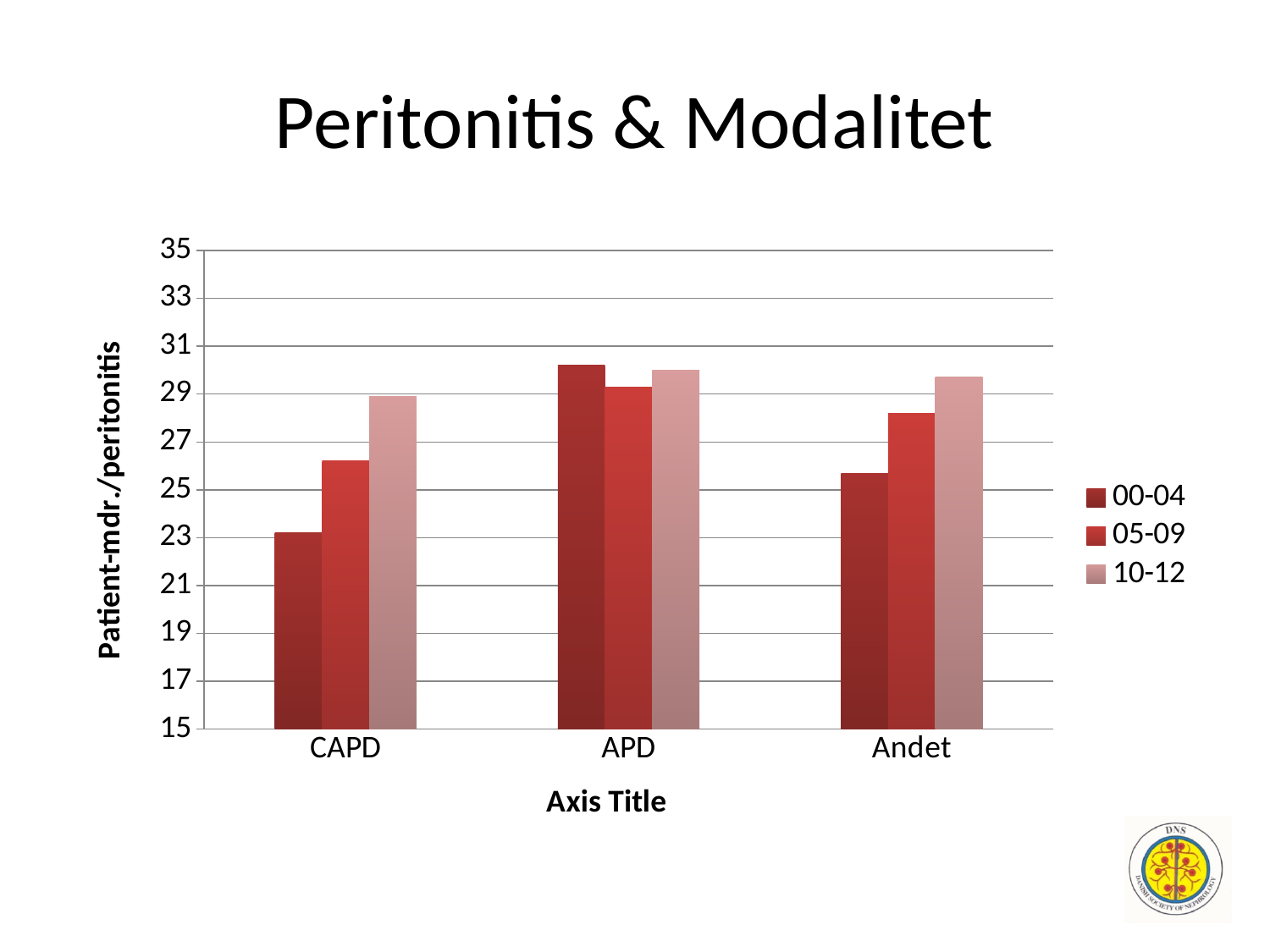
What kind of chart is shown on the slide? bar chart In the 00-04 series, which is larger: APD or Andet? APD Is the value for APD in the 00-04 series greater or less than 29? greater Is the value for CAPD in the 00-04 series greater or less than 25? less Is the value for CAPD in the 05-09 series greater or less than 27? less What is the title of the vertical axis? Patient-mdr./peritonitis How many series does the legend list? 3 Which bar is the lowest in the whole chart? CAPD, 00-04 How many categories are shown on the x axis? 3 In the 05-09 series, which category has the highest value? APD For CAPD, which is larger: the 00-04 value or the 10-12 value? 10-12 What are the legend entries of the chart? 00-04, 05-09, 10-12